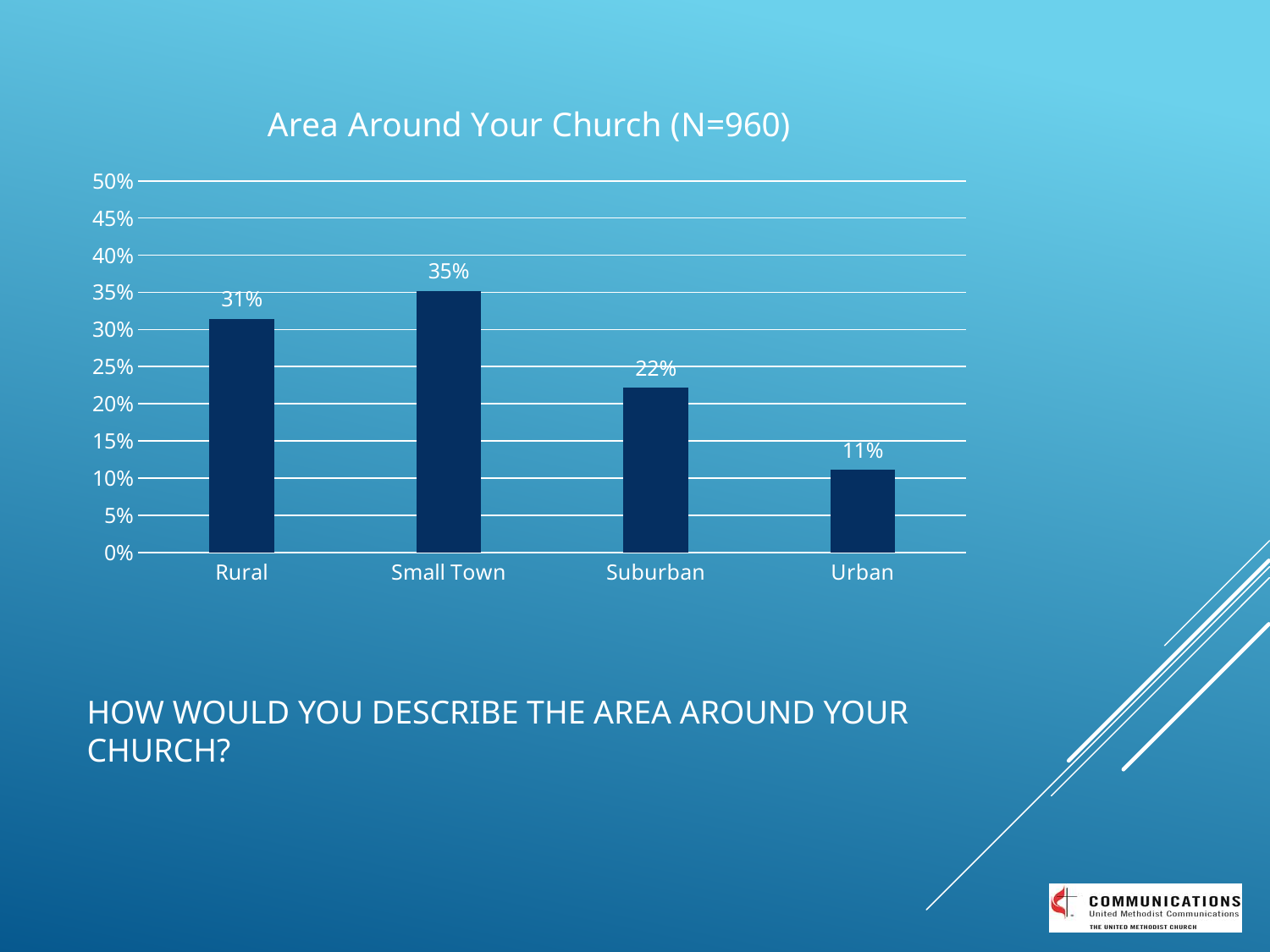
What kind of chart is shown on the slide? Bar chart Which is larger, the value for Rural or the value for Suburban? Rural What is the value for Suburban? 22% What is the value for Small Town? 35% How many categories are shown on the x axis? 4 What is the difference between the values for Small Town and Rural? 4% What is the title of the chart? Area Around Your Church (N=960) What is the difference between the values for Suburban and Urban? 11% What is the value for Urban? 11% Which category has the highest value? Small Town What is the value for Rural? 31% Which category has the lowest value? Urban